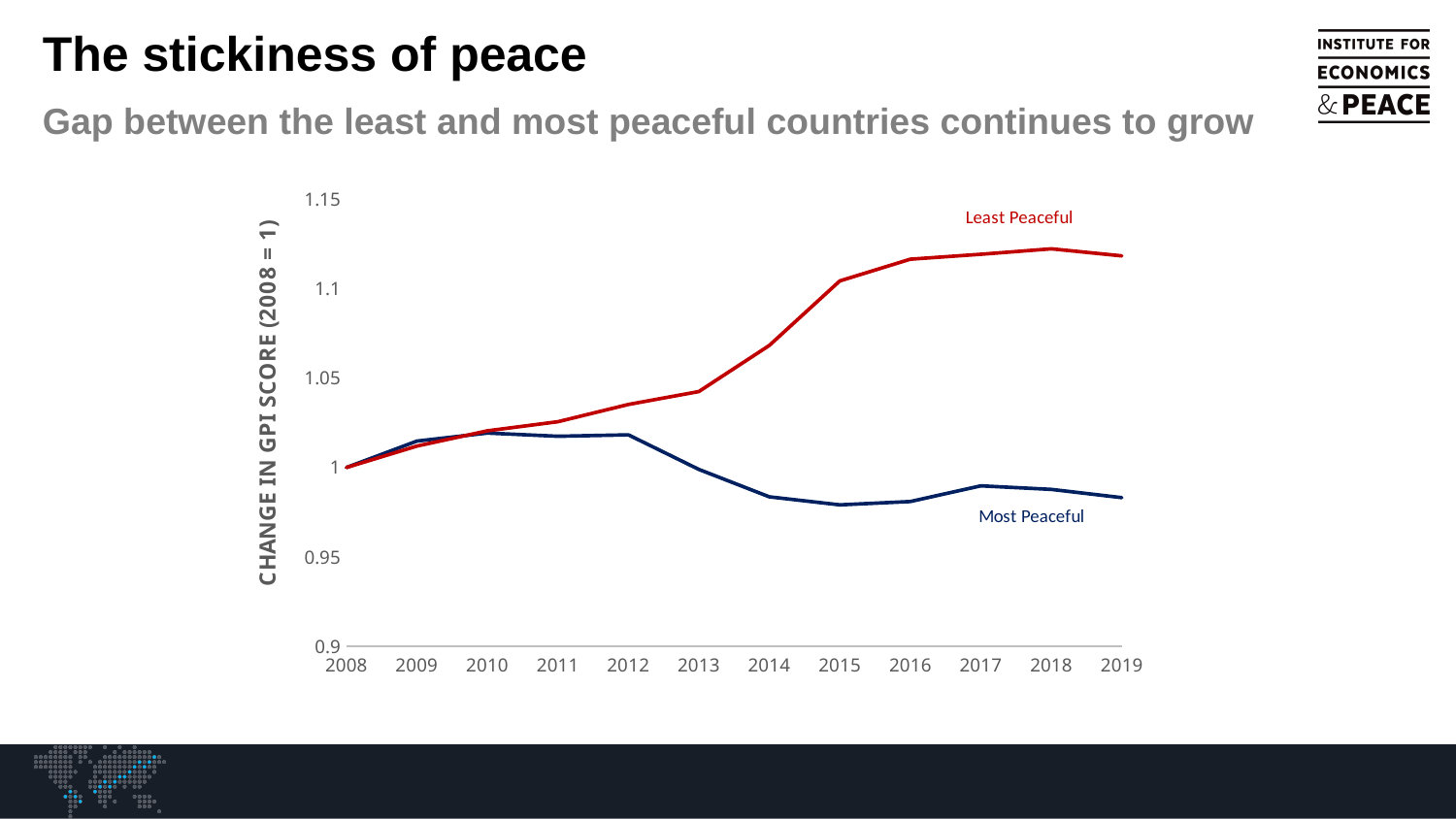
What type of chart is shown on the slide? line chart Is the value for Least Peaceful in 2019 greater or less than 1.1? greater What is the label on the y axis of the chart? CHANGE IN GPI SCORE (2008 = 1) Is the value for Least Peaceful in 2014 greater or less than 1.05? greater How many years are shown along the x axis? 12 What is the value for Least Peaceful in 2008? 1 In 2019, which series has the higher value, Least Peaceful or Most Peaceful? Least Peaceful How many series are plotted on the chart? 2 What is the value for Most Peaceful in 2008? 1 Is the value for Most Peaceful in 2019 greater or less than 1? less Does the Least Peaceful line rise or fall from 2008 to 2019? rise